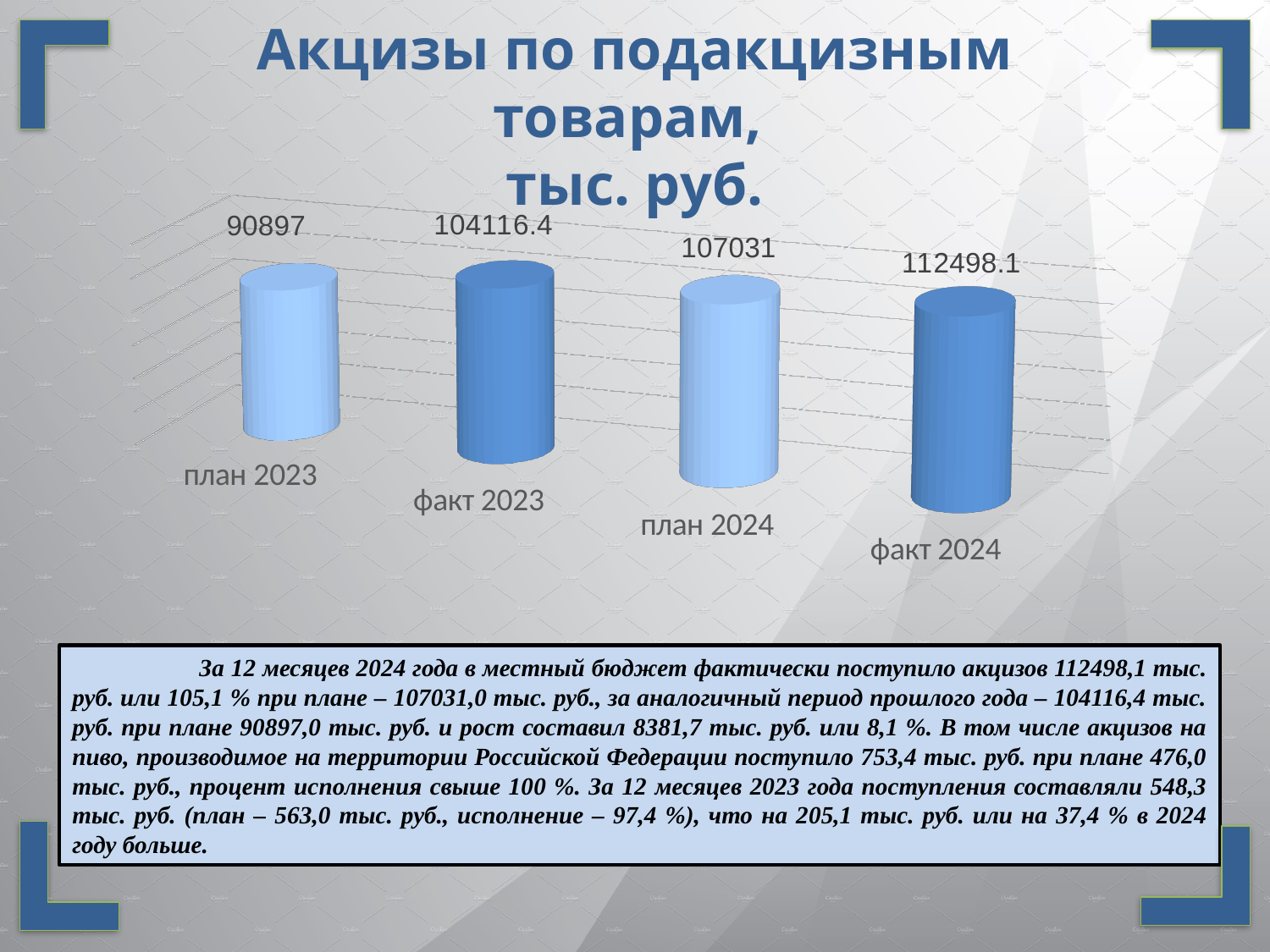
What is the value for план 2024? 107031 Which is larger, план 2024 or факт 2023? план 2024 What is the value for факт 2023? 104116.4 What is the difference between факт 2024 and факт 2023? 8381.7 What is the value for факт 2024? 112498.1 What kind of chart is shown on the slide? bar chart How many categories are shown in the chart? 4 What is the difference between факт 2023 and план 2023? 13219.4 Which category has the lowest value? план 2023 Do the values rise or fall from план 2023 to факт 2024? rise What is the value for план 2023? 90897 Which category has the highest value? факт 2024